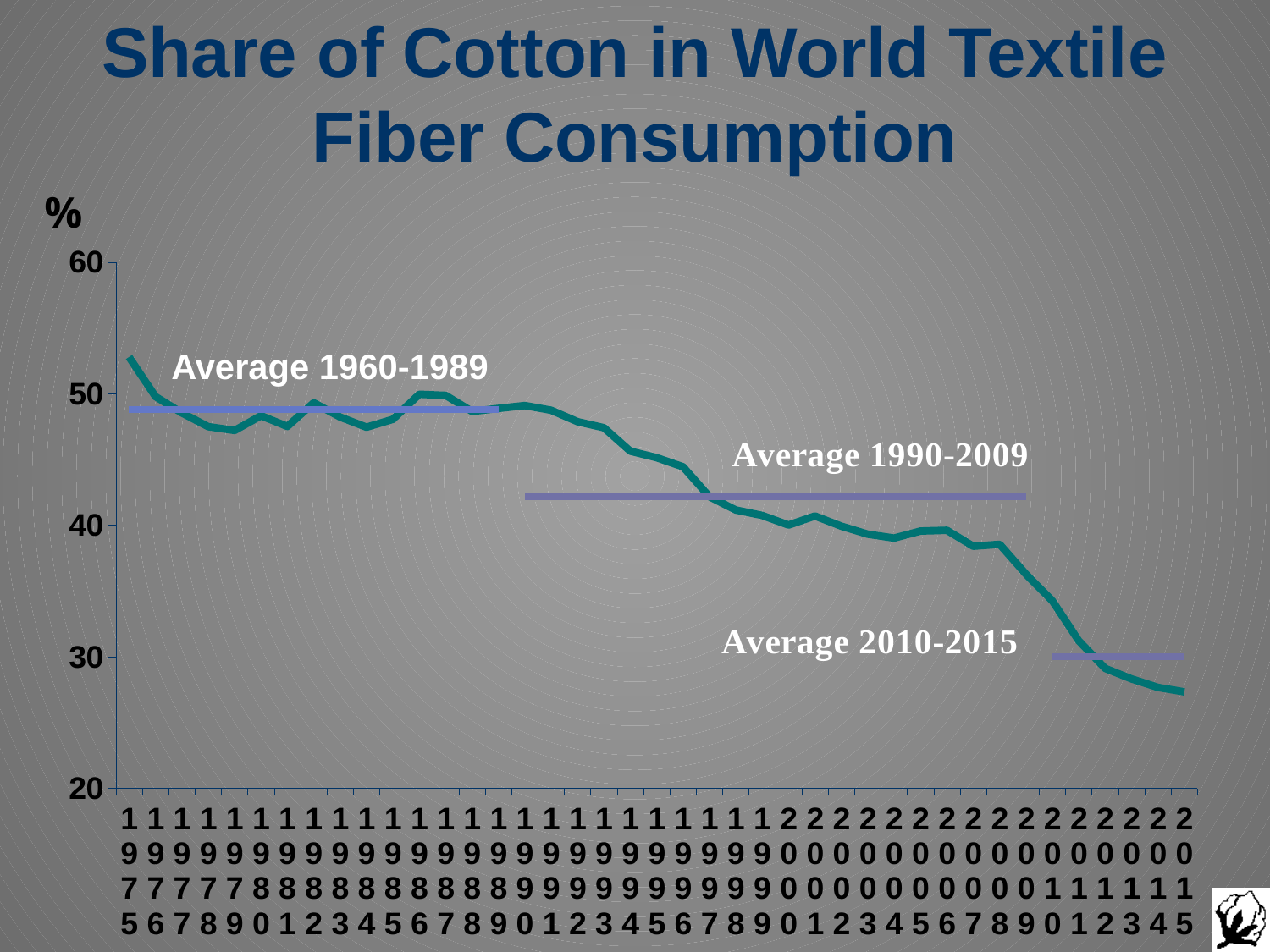
Is the value for 2010 greater or less than 40? less What kind of chart is shown on the slide? line chart How many years are plotted along the x axis of the chart? 41 What unit is shown on the y axis of the chart? % What is the title of the chart? Share of Cotton in World Textile Fiber Consumption Which year has the lowest share of cotton on the chart? 2015 Which year has the larger share of cotton, 1990 or 2010? 1990 Is the value for 1975 greater or less than 50? greater Is the value for 2015 greater or less than 30? less Which year has the highest share of cotton on the chart? 1975 Does the share of cotton generally rise or fall from 1975 to 2015? fall